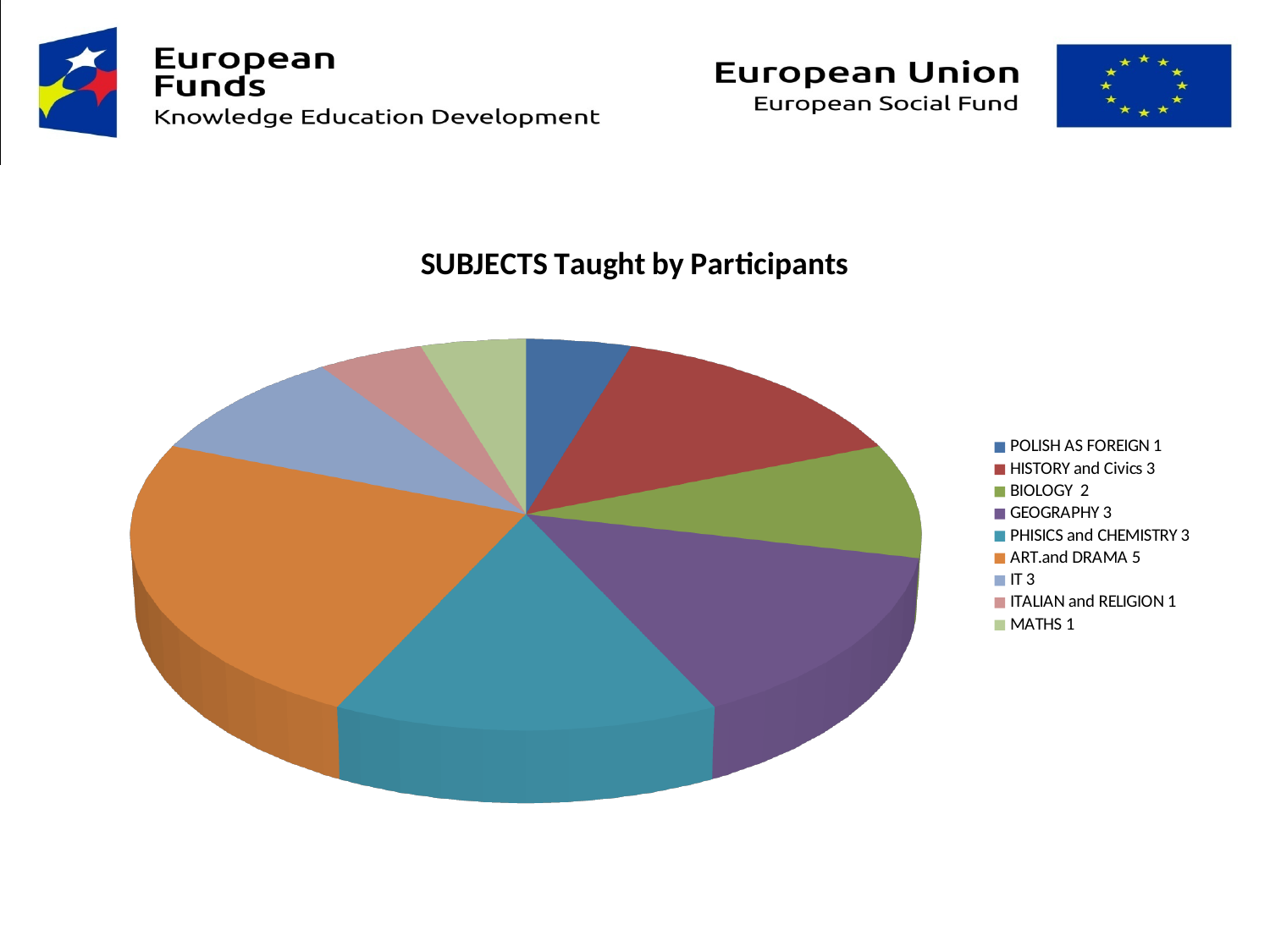
What is the total of all the values shown in the legend? 22 What is the value for IT? 3 Which subject has the largest slice of the pie? ART and DRAMA How many subject categories does the pie chart show? 9 How many participants teach ART and DRAMA? 5 What is the value for HISTORY and Civics? 3 Which is larger, the value for HISTORY and Civics or the value for BIOLOGY? HISTORY and Civics What is the title of the chart? SUBJECTS Taught by Participants What colour is the ART and DRAMA slice? orange What type of chart is shown on the slide? pie chart What is the value for BIOLOGY? 2 What is the difference between the values for ART and DRAMA and BIOLOGY? 3